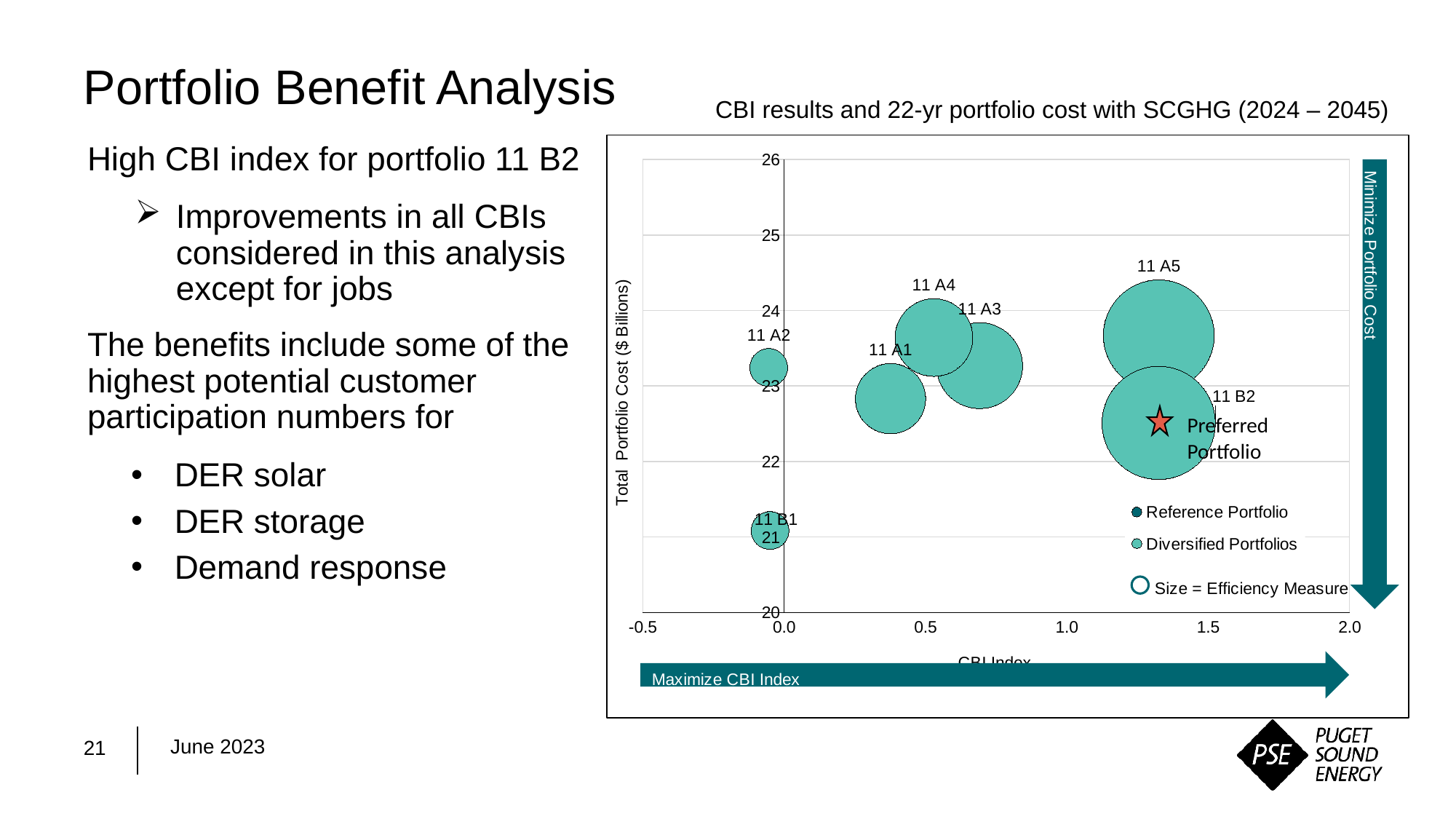
Which has the higher CBI Index, 11 A3 or 11 A1? 11 A3 Which has the higher total portfolio cost, 11 A5 or 11 B1? 11 A5 What kind of chart is shown on the slide? Bubble chart Is the CBI Index for 11 B2 greater or less than 1.0? greater Which portfolio is marked with a star as the Preferred Portfolio? 11 B2 Is the total portfolio cost for 11 A5 greater or less than 23? greater What is the label of the vertical axis of the chart? Total Portfolio Cost ($ Billions) Which portfolio has the lowest total portfolio cost? 11 B1 Is the total portfolio cost for 11 A4 greater or less than 23? greater